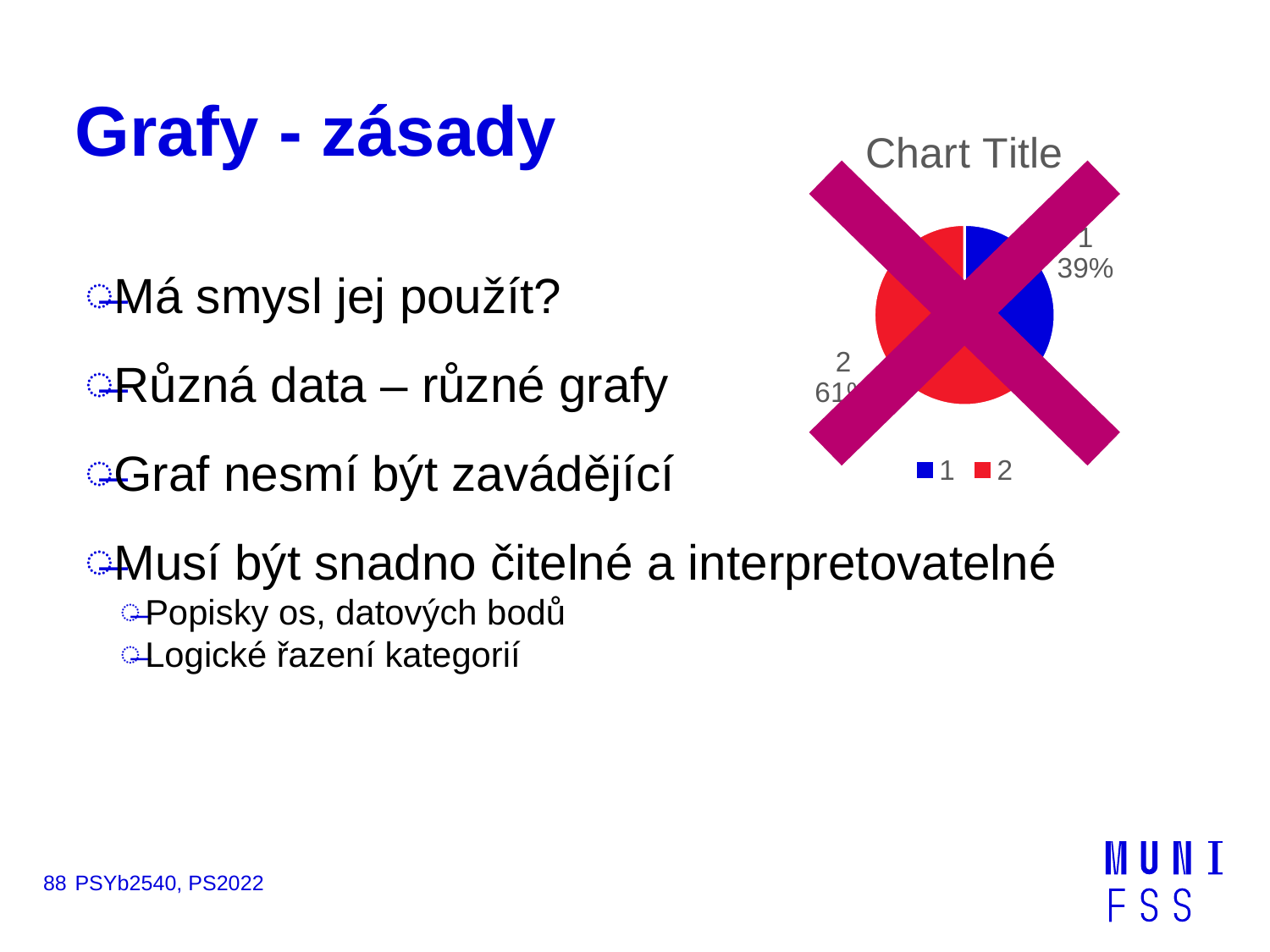
How many slices does the pie chart have? 2 How many entries does the chart's legend list? 2 What is the title of the chart on the slide? Chart Title Which slice is larger, category 1 or category 2? 2 What is the difference in percentage points between the slice for category 2 and the slice for category 1? 22% Which category has the largest slice of the pie? 2 What kind of chart is shown on the slide? pie chart What share of the pie does category 1 take? 39% Which category has the smallest slice of the pie? 1 What colour is the slice for category 1 in the pie chart? blue What share of the pie does category 2 take? 61%